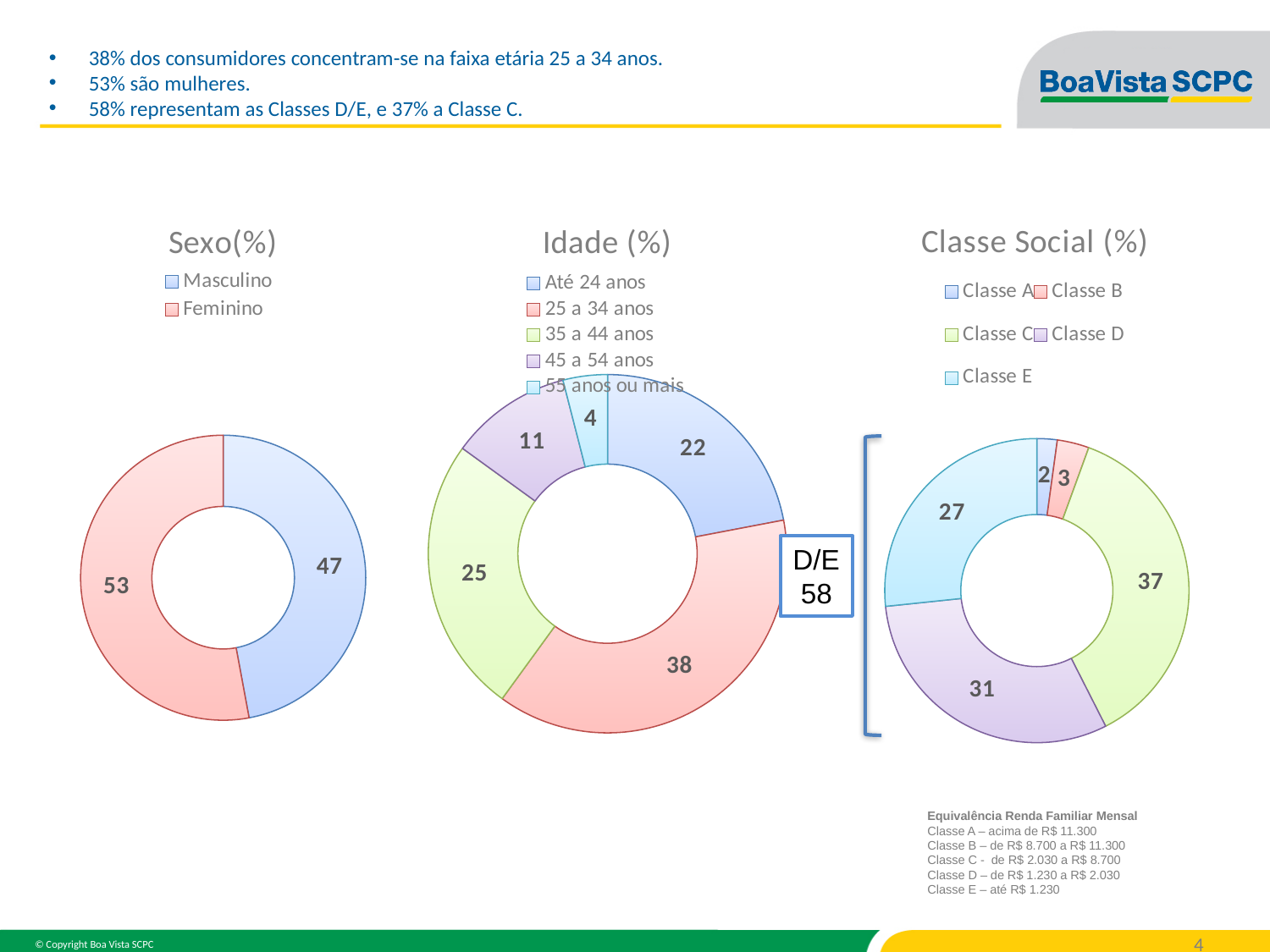
In the Classe Social (%) chart, what is the value for Classe D? 31 In the Sexo(%) chart, what is the value for Masculino? 47 In the Classe Social (%) chart, which class has the highest value? Classe C In the Idade (%) chart, which age group has the lowest value? 55 anos ou mais In the Idade (%) chart, how many age groups are shown? 5 In the Classe Social (%) chart, which is larger, Classe E or Classe D? Classe D In the Idade (%) chart, what is the difference between the values for 35 a 44 anos and 45 a 54 anos? 14 What type of chart is the Classe Social (%) chart? Doughnut chart In the Idade (%) chart, which age group has the highest value? 25 a 34 anos In the Sexo(%) chart, what is the value for Feminino? 53 In the Idade (%) chart, what is the value for 25 a 34 anos? 38 In the Sexo(%) chart, what is the difference between the Feminino and Masculino values? 6